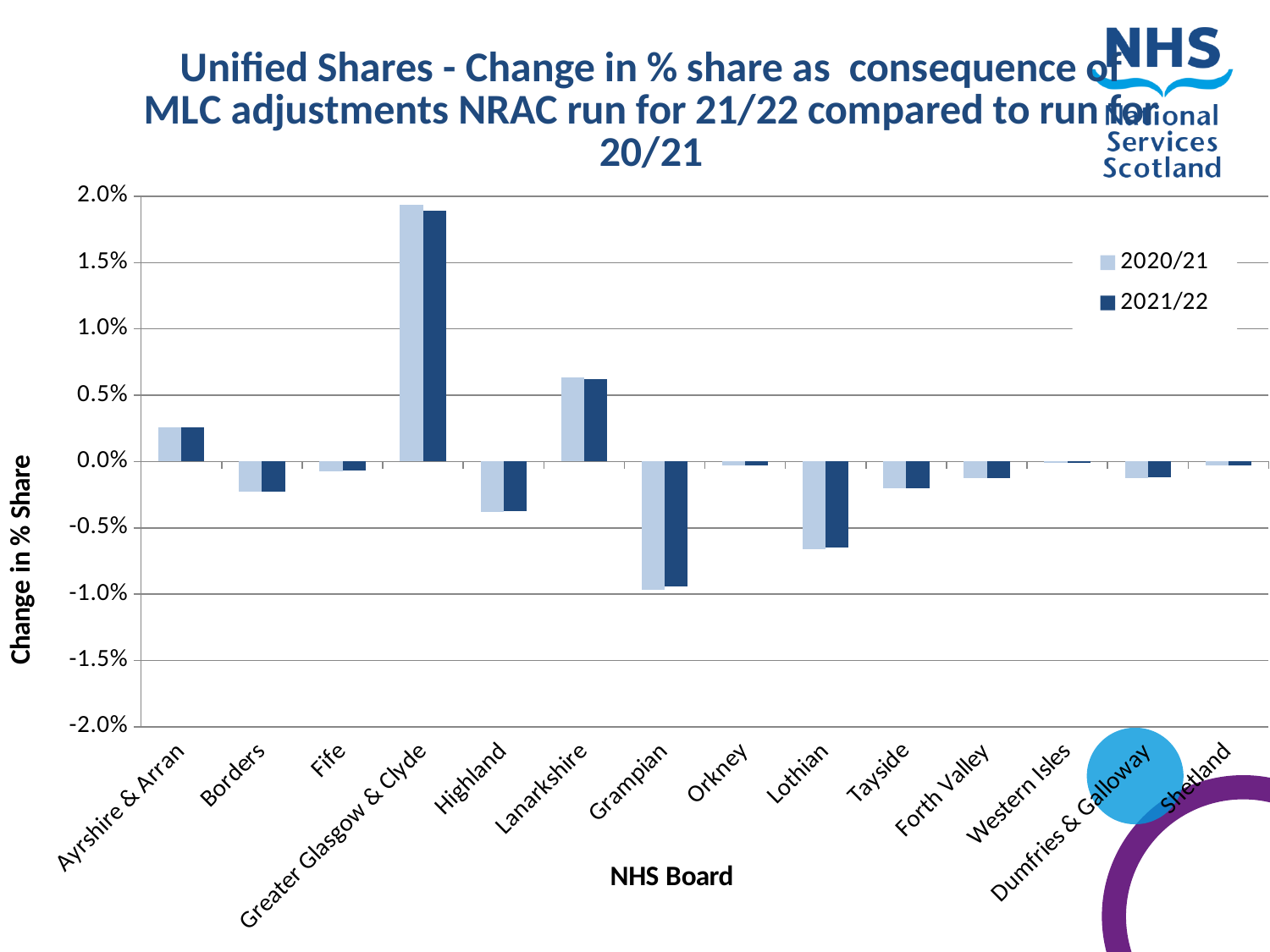
For 2021/22, which is larger: the value for Lanarkshire or the value for Ayrshire & Arran? Lanarkshire How many NHS Boards are shown on the x axis of the chart? 14 Is the 2020/21 value for Lanarkshire greater or less than 0.5%? greater Is the 2020/21 value for Grampian greater or less than -0.5%? less For 2020/21, which is larger: the value for Lothian or the value for Grampian? Lothian How many series does the chart's legend list? 2 What is the label on the chart's vertical axis? Change in % Share What kind of chart is shown on the slide? bar chart Is the 2021/22 value for Greater Glasgow & Clyde greater or less than 1.5%? greater Which NHS Board has the highest change in % share in the chart? Greater Glasgow & Clyde Which NHS Board has the lowest change in % share in the chart? Grampian